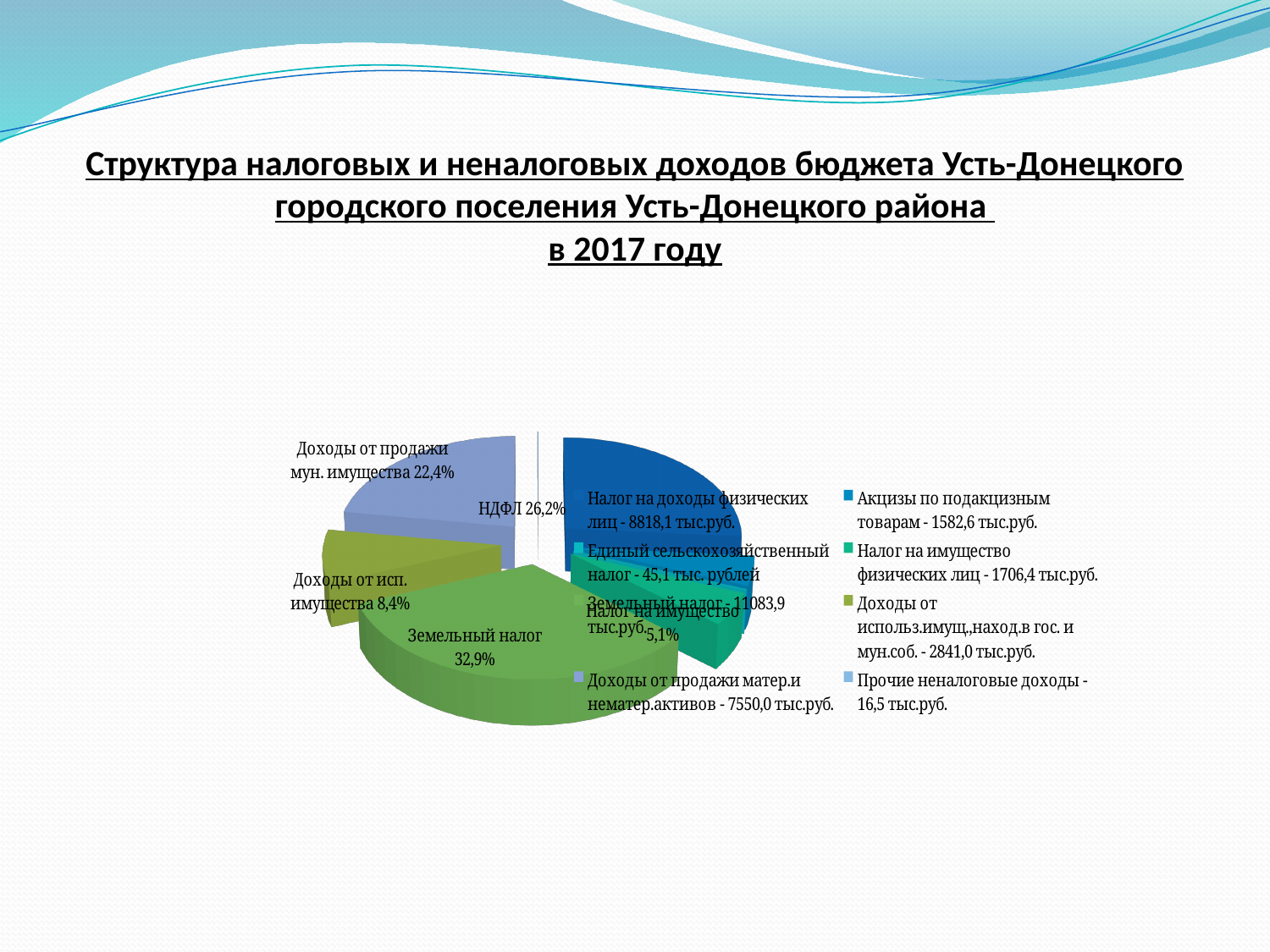
Which labelled slice of the pie is the largest? Земельный налог Which slice is larger: Доходы от продажи мун. имущества or Доходы от исп. имущества? Доходы от продажи мун. имущества According to the legend, what amount is given for Земельный налог? 11083,9 тыс.руб. What kind of chart is shown on the slide? pie chart What share of the pie does Земельный налог account for? 32,9% Which labelled slice of the pie is the smallest? Налог на имущество What share of the pie does НДФЛ account for? 26,2% What share of the pie does Доходы от исп. имущества account for? 8,4% By how many percentage points does the share of Земельный налог exceed the share of НДФЛ? 6,7 How many entries does the legend list? 8